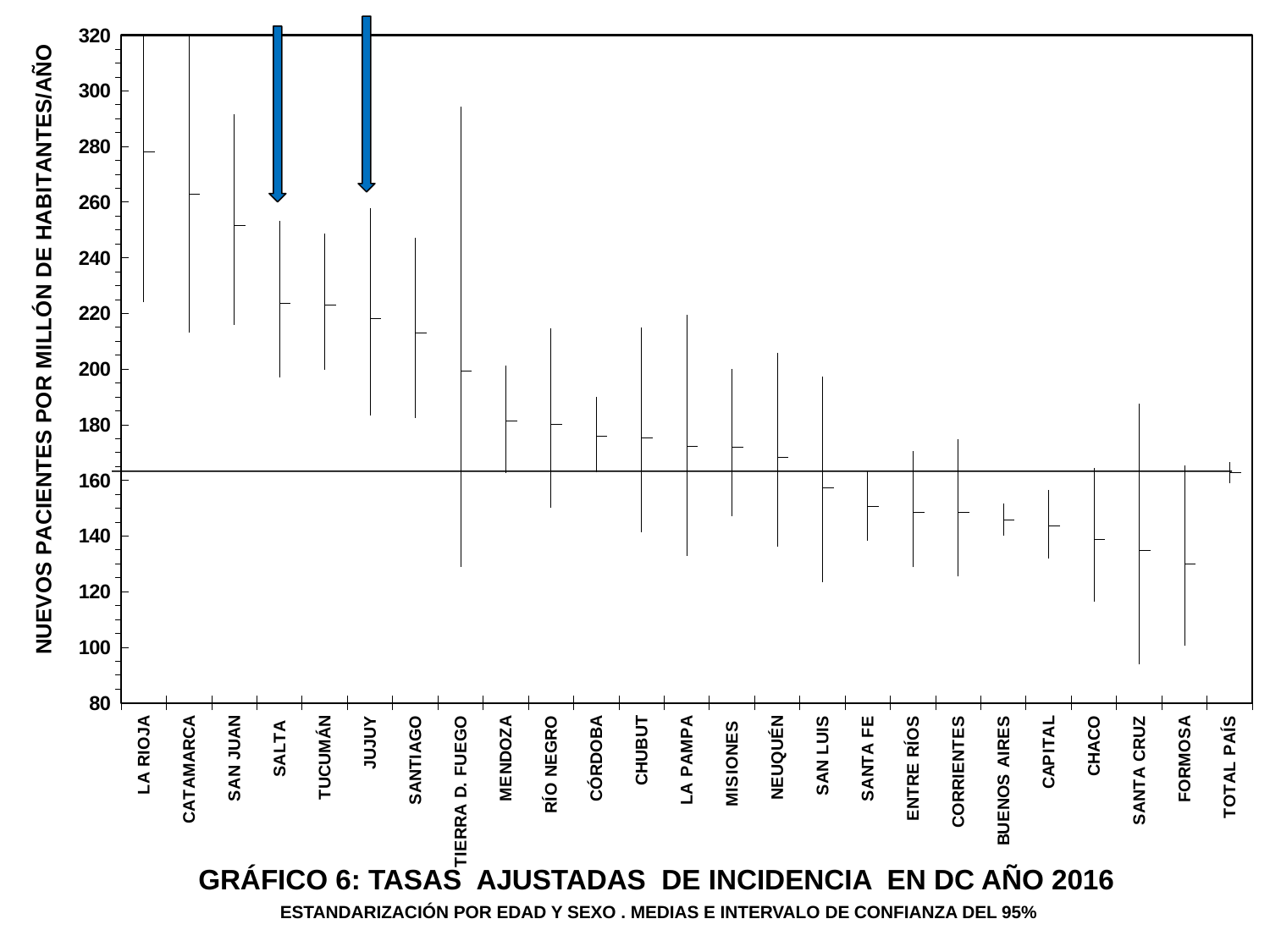
How many categories (provinces plus the national total) are shown along the x axis? 25 Which category has the highest mean value? LA RIOJA Is the mean value for SALTA greater or less than 240? less What is the label of the vertical axis? NUEVOS PACIENTES POR MILLÓN DE HABITANTES/AÑO Is the mean value for FORMOSA greater or less than 140? less Is the mean value for MENDOZA greater or less than 200? less What is the title of the chart? GRÁFICO 6: TASAS AJUSTADAS DE INCIDENCIA EN DC AÑO 2016 Do the mean values generally rise or fall moving from left to right along the x axis? fall Which has a higher mean value, LA RIOJA or CATAMARCA? LA RIOJA Which has a higher mean value, MENDOZA or CHACO? MENDOZA